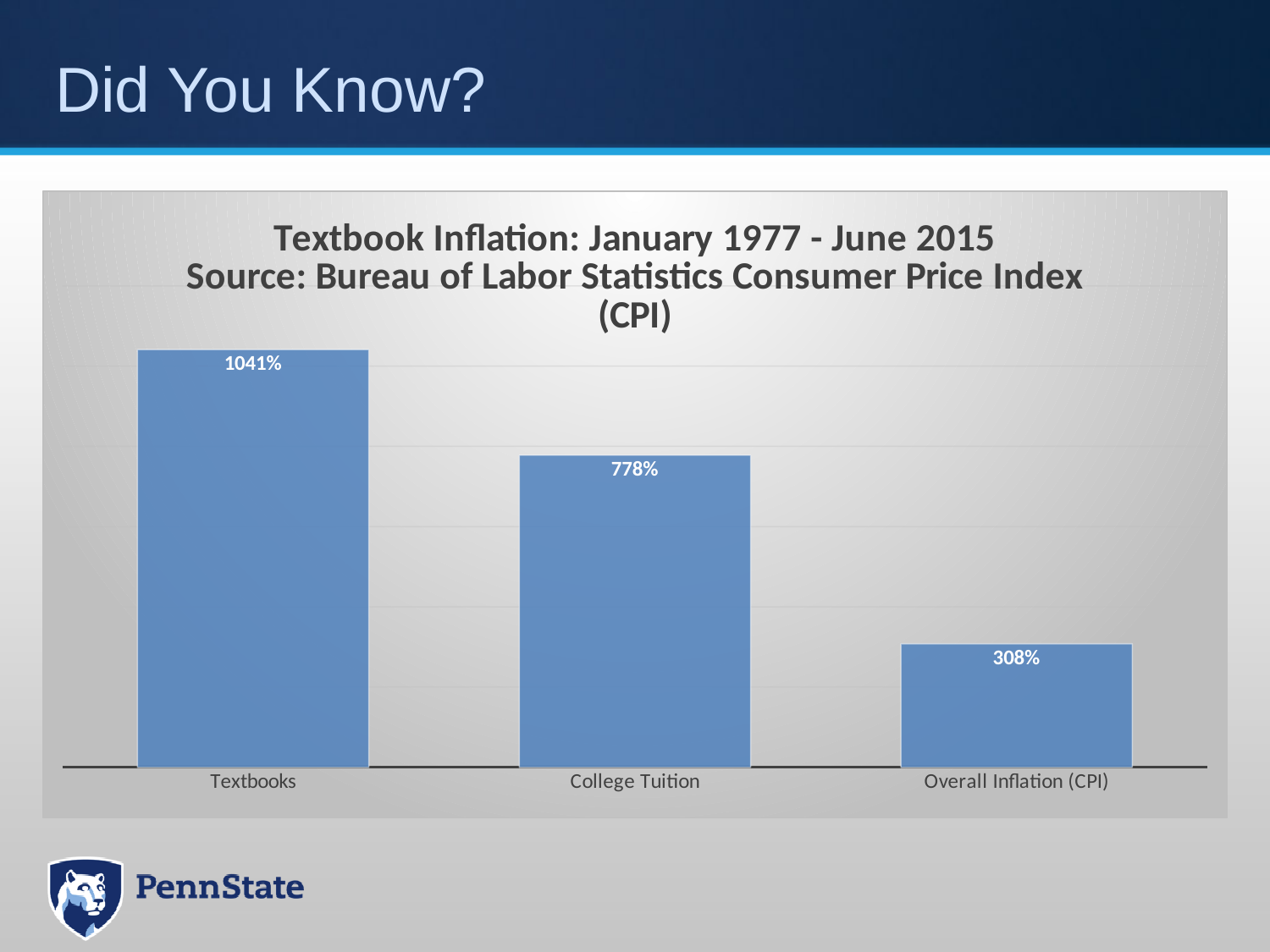
What is the difference between the values for Textbooks and College Tuition? 263% How many categories are shown in the chart? 3 What is the value for Textbooks? 1041% What is the difference between the values for College Tuition and Overall Inflation (CPI)? 470% What time period does the chart title say the textbook inflation covers? January 1977 - June 2015 Which is larger, the value for College Tuition or the value for Overall Inflation (CPI)? College Tuition What is the value for College Tuition? 778% Which category has the highest value? Textbooks What is the value for Overall Inflation (CPI)? 308% What kind of chart is shown on the slide? Bar chart Do the values rise or fall from left to right across the categories? Fall Which category has the lowest value? Overall Inflation (CPI)